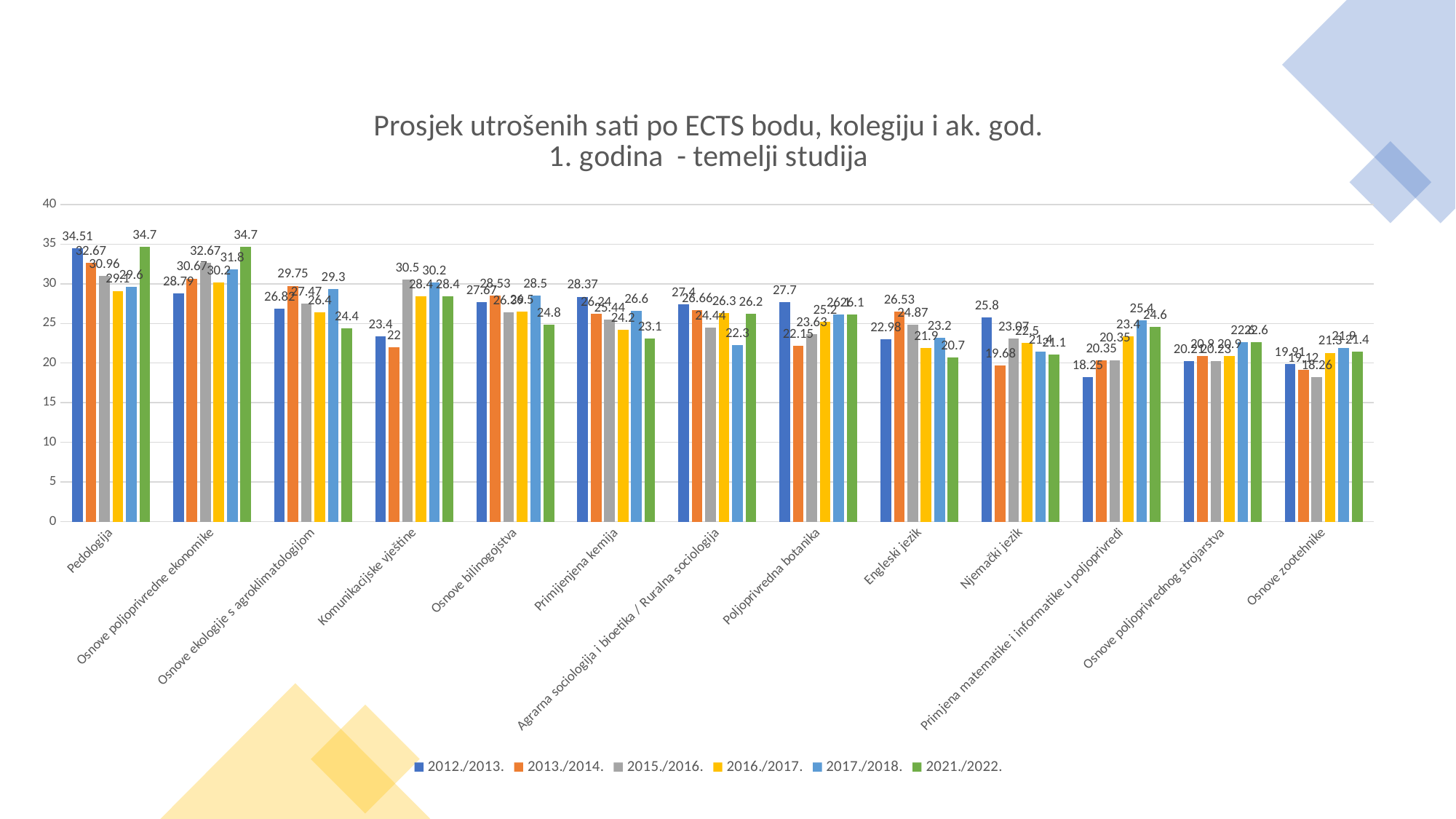
What is the value for Pedologija in 2012./2013.? 34.51 What is the value for Komunikacijske vještine in 2015./2016.? 30.5 For Engleski jezik, which is larger: the 2012./2013. value or the 2013./2014. value? 2013./2014. What is the value for Poljoprivredna botanika in 2013./2014.? 22.15 What is the title of the chart? Prosjek utrošenih sati po ECTS bodu, kolegiju i ak. god. 1. godina - temelji studija Is the value for Osnove zootehnike in 2015./2016. greater or less than 20? less What kind of chart is shown on the slide? bar chart For Njemački jezik, which academic year has the highest value? 2012./2013. How many series does the legend list? 6 For Primjena matematike i informatike u poljoprivredi, which academic year has the lowest value? 2012./2013. How many courses (categories) are shown on the x axis? 13 For Komunikacijske vještine, what is the difference between the 2015./2016. value and the 2013./2014. value? 8.5